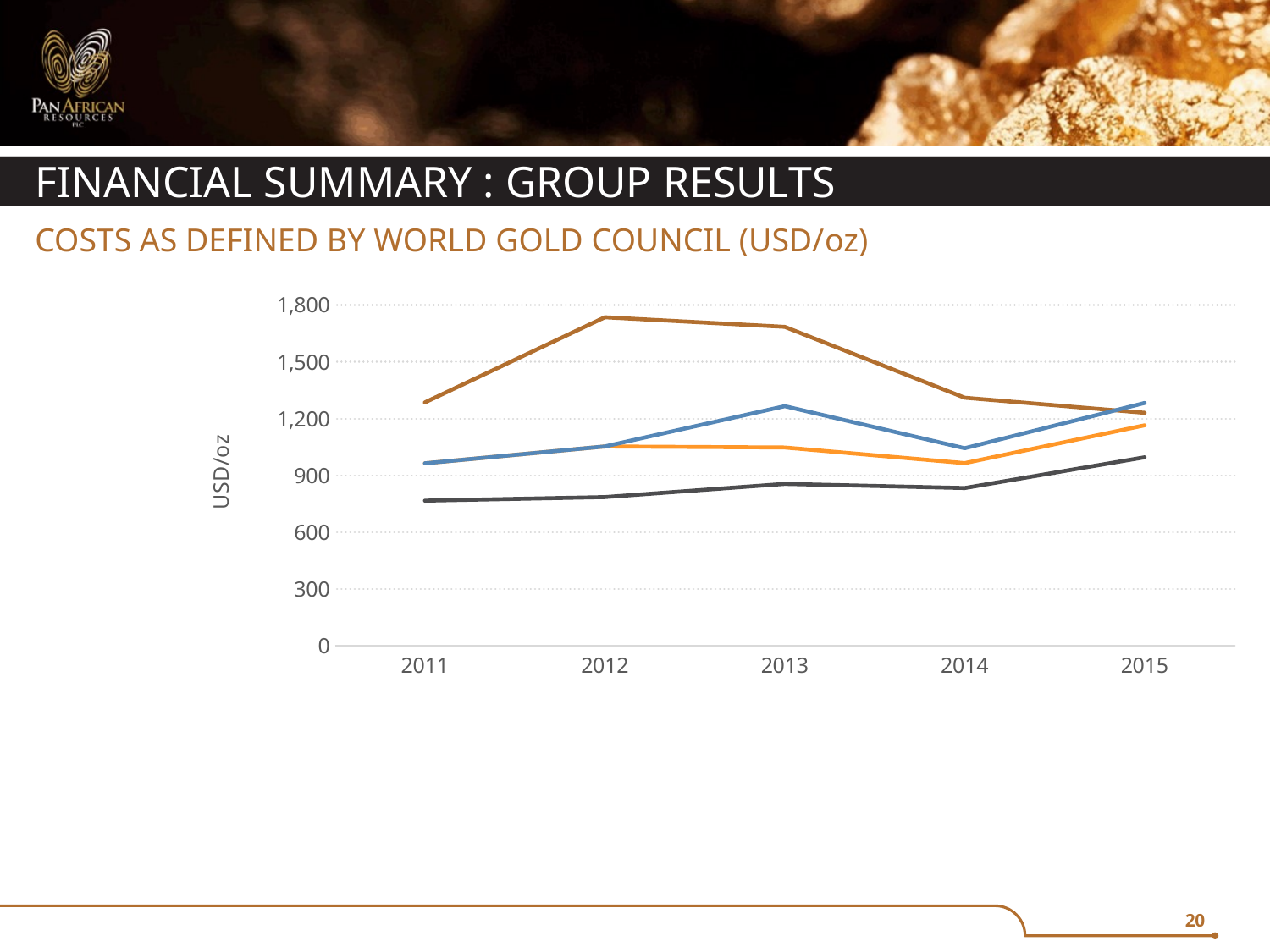
In which year does the brown line reach its highest value? 2012 In which year is the dark grey line at its lowest value? 2011 What is the label on the vertical axis of the chart? USD/oz Is the value of the brown line in 2012 greater or less than 1,500? greater How many years are shown along the x axis of the chart? 5 Is the value of the orange line in 2014 greater or less than 1,200? less Is the value of the dark grey line in 2011 greater or less than 900? less Which line has the higher value in 2012, the brown line or the dark grey line? brown line What is the title of the chart? COSTS AS DEFINED BY WORLD GOLD COUNCIL (USD/oz) Does the brown line rise or fall from 2012 to 2014? fall What kind of chart is shown on the slide? line chart